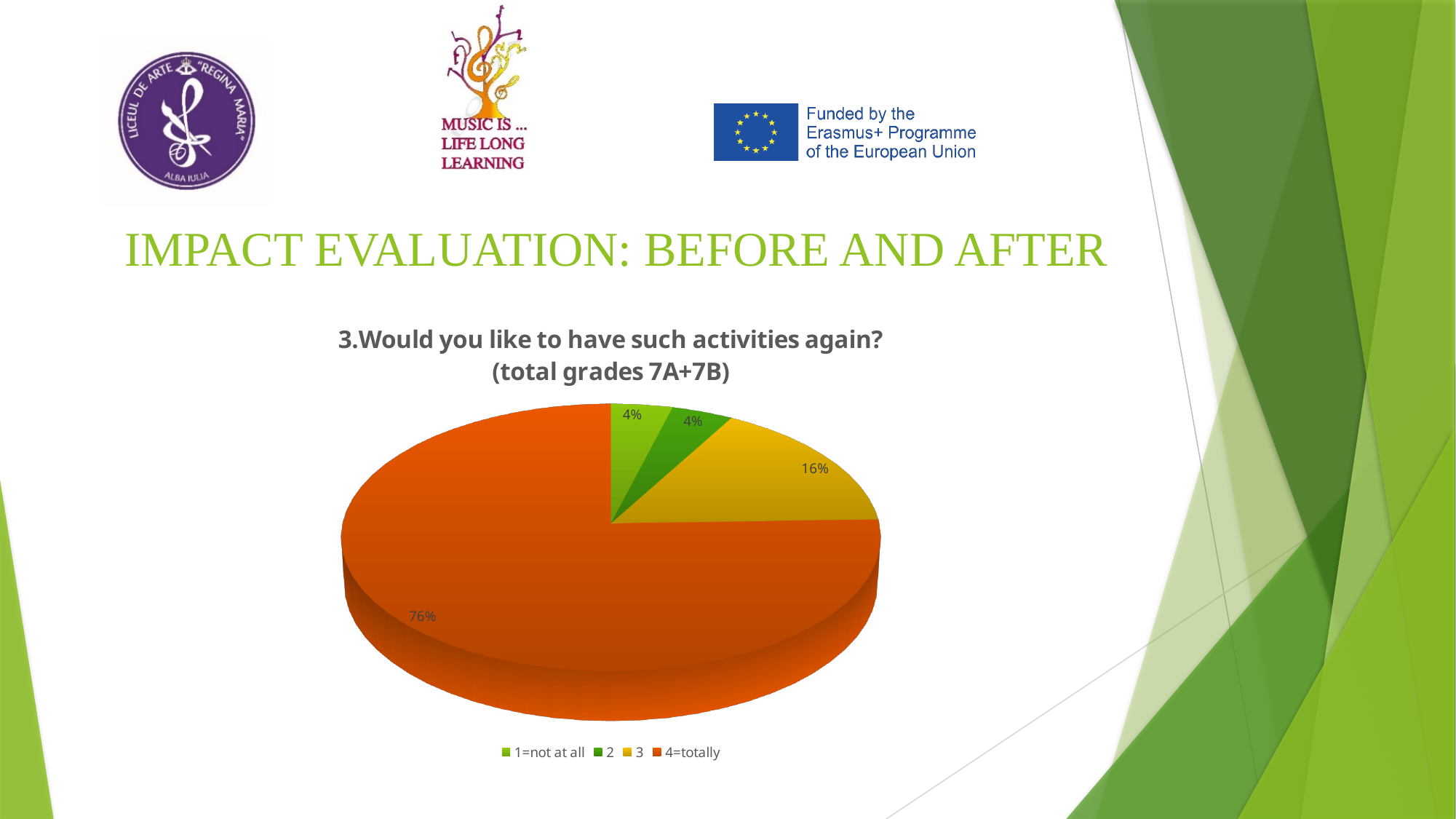
What is the title of the chart? 3.Would you like to have such activities again? (total grades 7A+7B) What colour is the "4=totally" slice? orange How many categories does the legend list? 4 What share of the pie does the "3" slice represent? 16% What share of the pie does the "2" slice represent? 4% Which is larger, the "3" slice or the "2" slice? 3 What is the combined share of the "1=not at all" and "2" slices? 8% What is the difference in percentage points between the "4=totally" slice and the "3" slice? 60 What share of the pie does the "4=totally" slice represent? 76% What kind of chart is shown on the slide? pie chart Which category has the largest slice of the pie? 4=totally